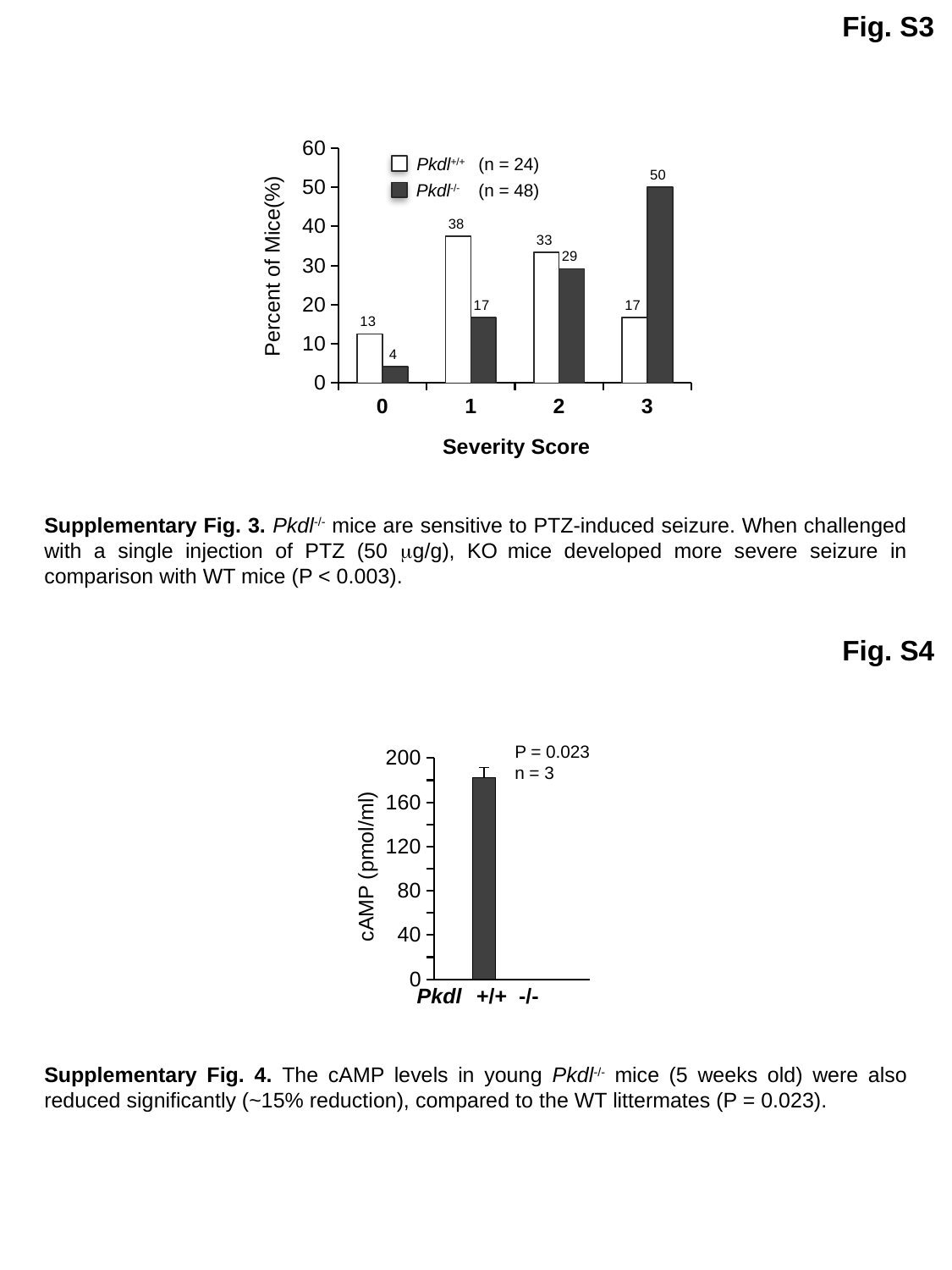
In the Fig. S3 chart, how many groups does the legend list? 2 In the Fig. S3 chart, what percent of Pkdl-/- mice had a severity score of 3? 50 What kind of chart is the Fig. S4 chart? bar chart In the Fig. S3 chart, what is the difference between the Pkdl-/- and Pkdl+/+ values at severity score 3? 33 In the Fig. S3 chart, what is the value for Pkdl-/- mice at severity score 0? 4 In the Fig. S3 chart, which severity score has the highest value for Pkdl-/- mice? 3 In the Fig. S3 chart, what is the sample size (n) for the Pkdl-/- group shown in the legend? 48 In the Fig. S4 chart, is the cAMP value for Pkdl +/+ greater or less than 160? greater In the Fig. S3 chart, how many severity score categories are shown on the x axis? 4 In the Fig. S3 chart, what percent of Pkdl+/+ mice had a severity score of 1? 38 In the Fig. S3 chart, which severity score has the lowest value for Pkdl+/+ mice? 0 In the Fig. S3 chart, at severity score 2, which group has the larger value, Pkdl+/+ or Pkdl-/-? Pkdl+/+